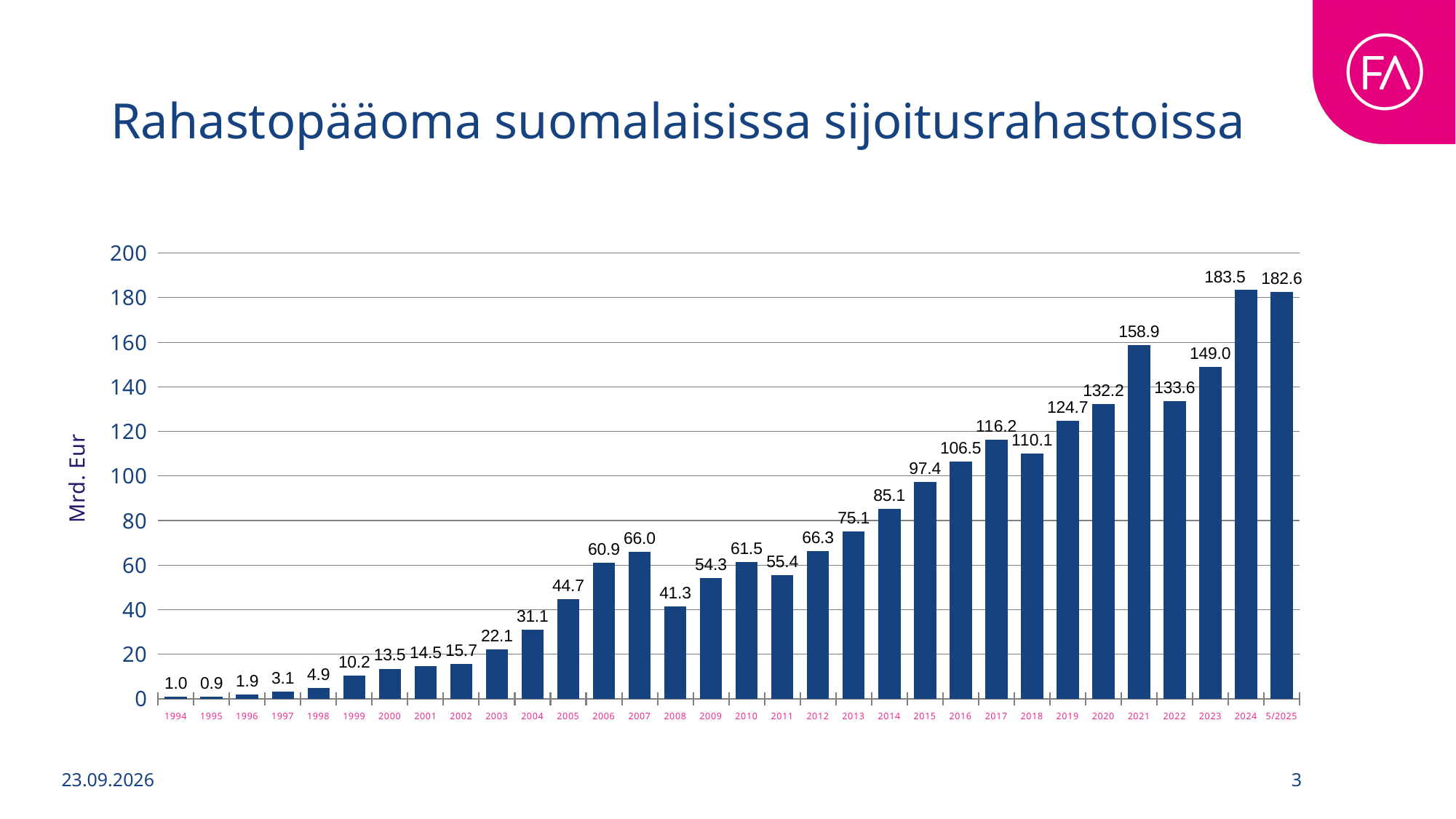
What is the difference between the values for 2024 and 2023? 34.5 Which year has the lowest value? 1995 What is the value for 2008? 41.3 Which is larger, the value for 2007 or the value for 2012? 2012 What is the value for 2024? 183.5 What is the value for 5/2025? 182.6 What is the difference between the values for 2021 and 2022? 25.3 How many bars are shown in the chart? 32 What is the label on the vertical axis? Mrd. Eur Is the value for 2019 greater or less than 120? greater What kind of chart is shown on the slide? bar chart Which year has the highest value? 2024